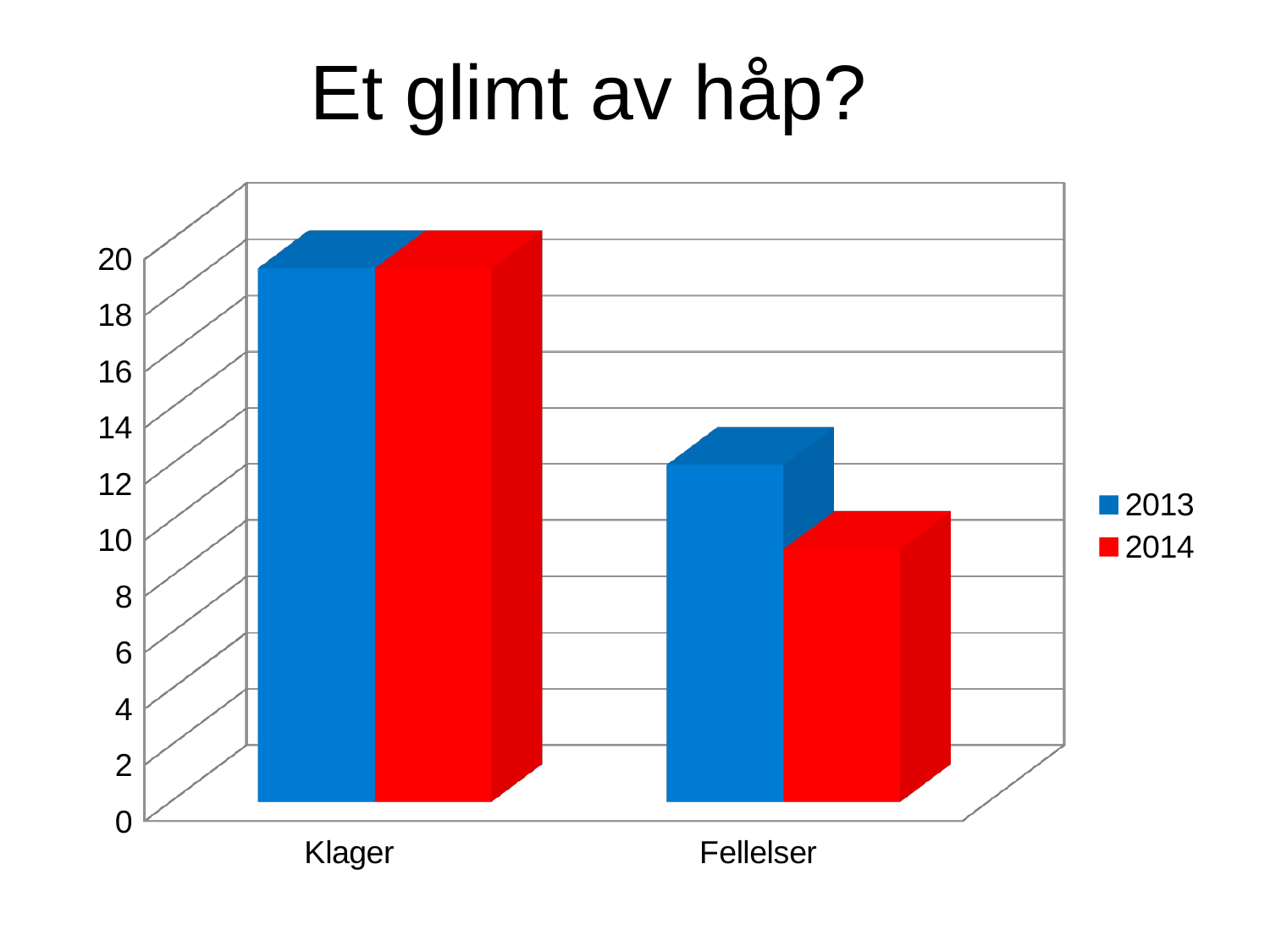
For the 2014 series, which category has the lowest value? Fellelser For the 2013 series, which category has the larger value, Klager or Fellelser? Klager How many series does the chart's legend list? 2 How many categories are shown on the x axis of the chart? 2 Do the values for the 2014 series rise or fall from Klager to Fellelser? fall What kind of chart is shown on the slide? bar chart For the 2013 series, which category has the highest value? Klager What is the title of the slide containing the chart? Et glimt av håp? Is the value for Fellelser in 2014 greater or less than 14? less For Fellelser, which series has the larger value, 2013 or 2014? 2013 Is the value for Fellelser in 2013 greater or less than 10? greater Which series is shown in red in the chart? 2014